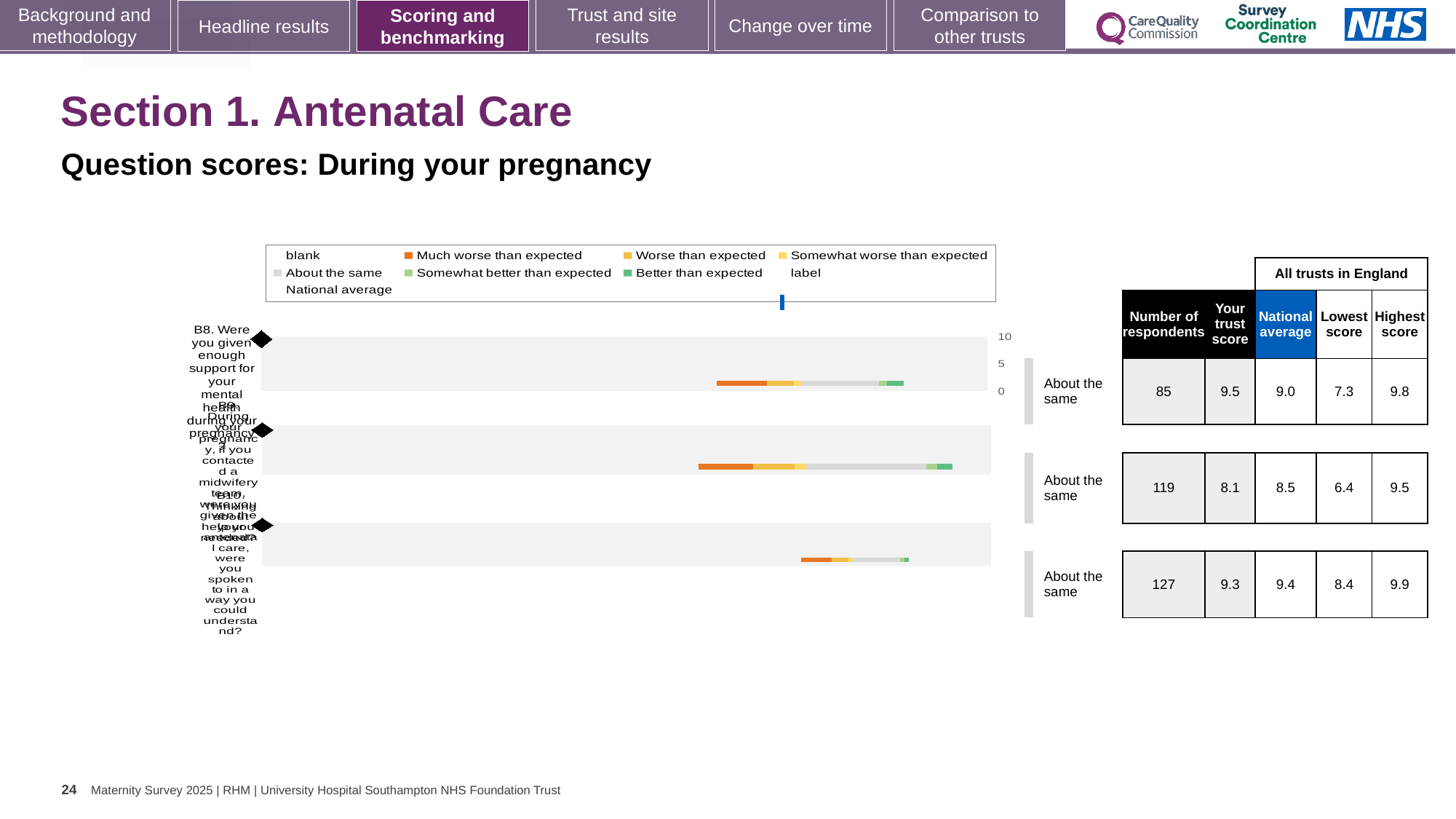
What is the lowest score across all trusts in England for the third question row? 8.4 What is the difference between the trust score and the national average for the first question (B8)? 0.5 What kind of chart is used to show the question scores on this slide? bar chart What is the subtitle describing the chart on this slide? Question scores: During your pregnancy Which question row has the highest number of respondents? the third row (127) Which question row has the lowest trust score? the second row (8.1) How many questions (bars) are plotted in the chart? 3 For the second question row, which is larger: the trust score or the national average? the national average What is the number of respondents for the first question (B8, support for your mental health during pregnancy)? 85 What benchmark rating is shown next to each of the three question bars? About the same What is the national average for the second question row in the table? 8.5 What is the trust score for the first question (B8) in the table? 9.5